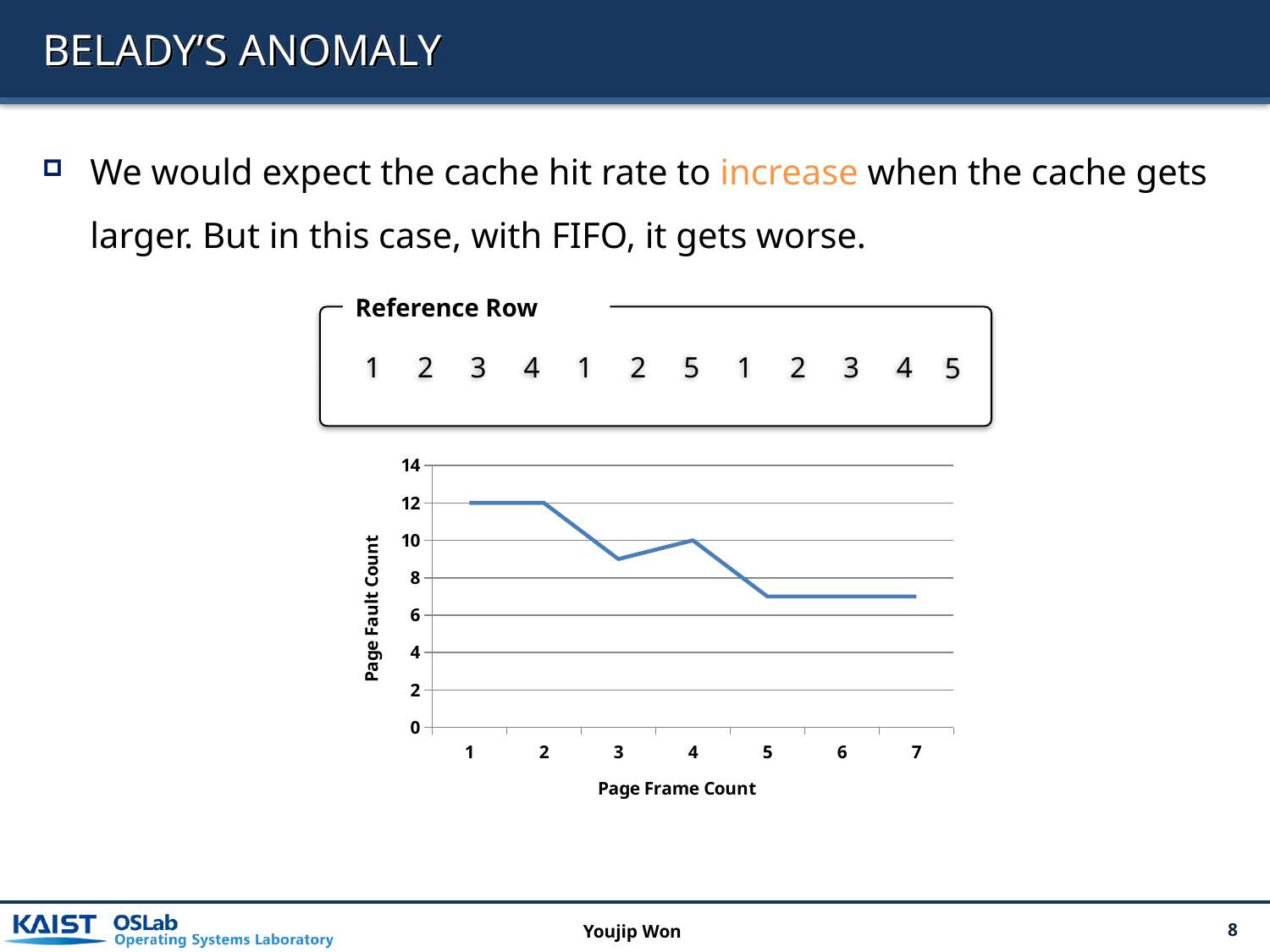
What is the page fault count when the page frame count is 2? 12 How many page frame count values are plotted on the x axis? 7 What kind of chart is shown on the slide? line chart What is the page fault count when the page frame count is 1? 12 Which has a higher page fault count: a page frame count of 3 or a page frame count of 4? 4 Is the page fault count for a page frame count of 5 greater or less than 8? less What is the title of the y axis of the chart? Page Fault Count What is the difference in page fault count between a page frame count of 1 and a page frame count of 4? 2 Overall, does the page fault count rise or fall as the page frame count increases? fall What is the page fault count when the page frame count is 4? 10 Is the page fault count for a page frame count of 7 greater or less than 6? greater Is the page fault count for a page frame count of 3 greater or less than 10? less